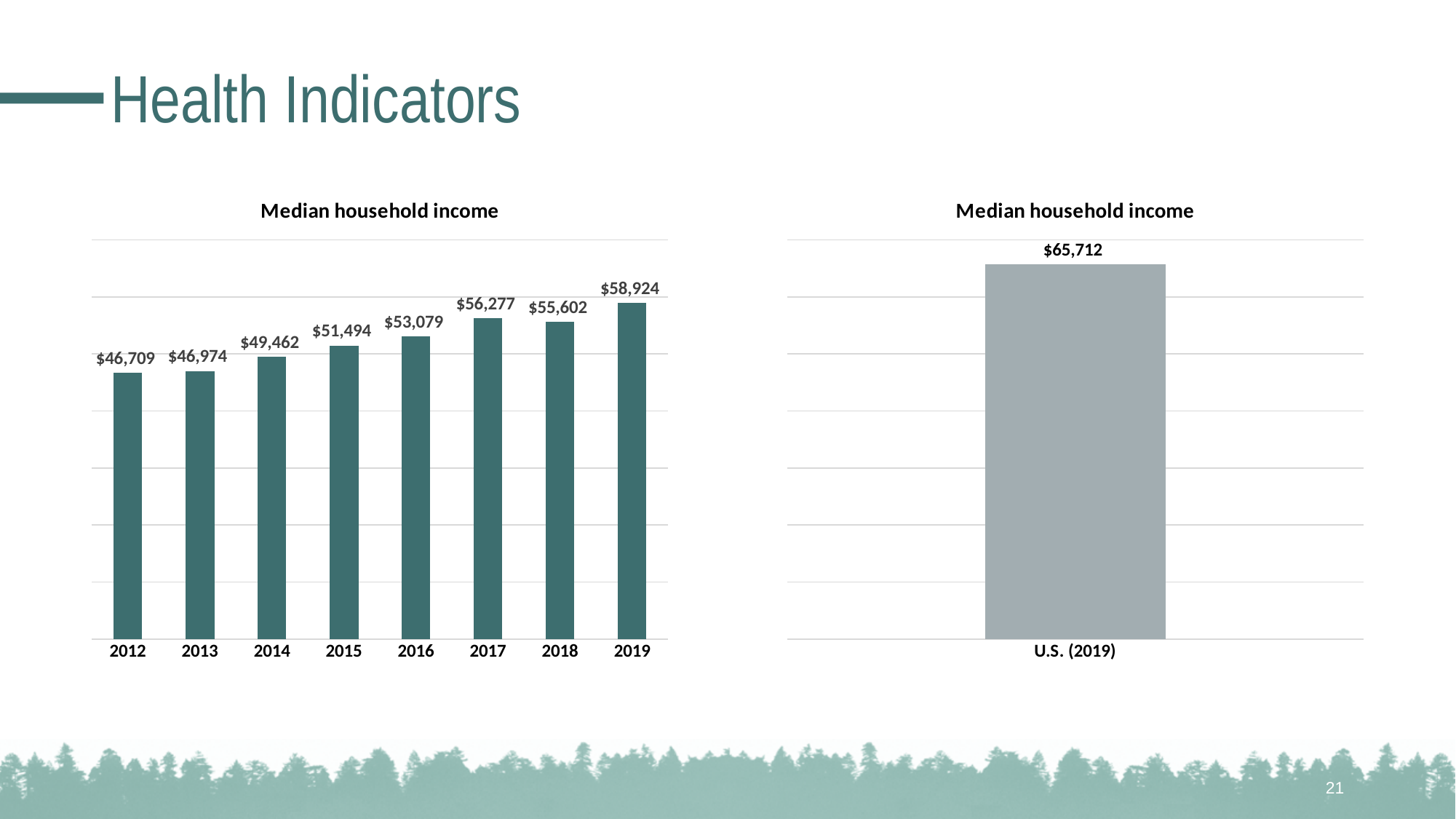
In the left chart, is the median household income higher in 2017 or in 2018? 2017 Which is larger: the 2019 value in the left chart or the U.S. (2019) value in the right chart? U.S. (2019) In the left chart, what is the difference between the median household income in 2019 and in 2012? $12,215 In the left chart, what is the median household income for 2012? $46,709 In the left chart, which year has the lowest median household income? 2012 In the left chart, which year has the highest median household income? 2019 In the left chart, does median household income generally rise or fall from 2012 to 2019? Rise What kind of chart is the left chart? Bar chart In the right chart, what is the median household income for U.S. (2019)? $65,712 In the left chart, what is the difference between the median household income in 2017 and in 2018? $675 How many years are shown on the x axis of the left chart? 8 In the left chart, what is the median household income for 2017? $56,277